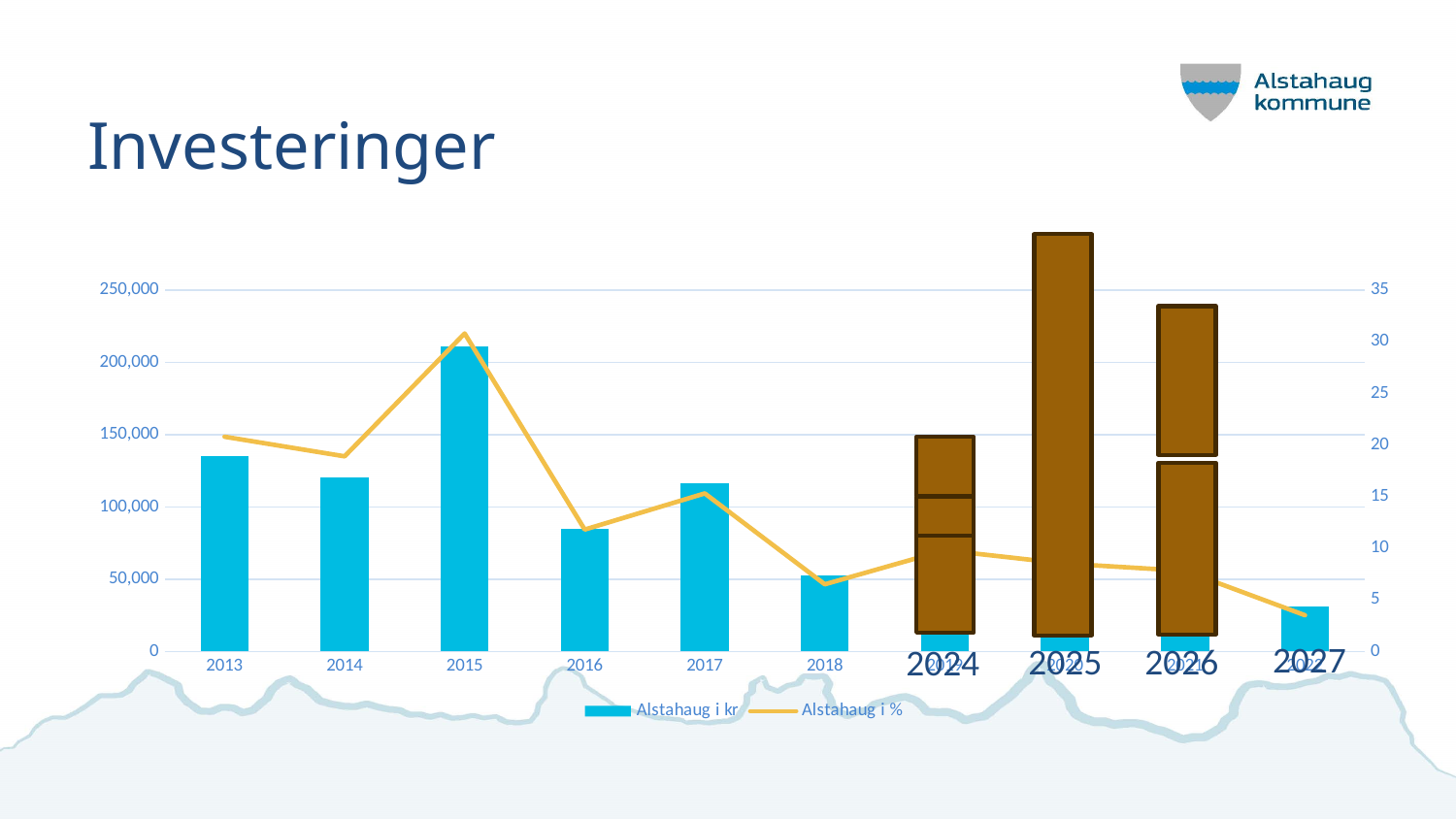
Which year has the highest bar for Alstahaug i kr? 2015 Do the Alstahaug i kr bars rise or fall from 2015 to 2018? fall Is the Alstahaug i kr bar for 2013 greater or less than 150,000? less Is the Alstahaug i kr bar for 2016 greater or less than 100,000? less What are the two series named in the legend? Alstahaug i kr and Alstahaug i % Which year has the larger Alstahaug i kr bar, 2013 or 2014? 2013 In which year does the Alstahaug i % line reach its highest point? 2015 What kind of chart is shown on the slide? A combined bar and line chart Is the Alstahaug i kr bar for 2017 greater or less than 100,000? greater How many series does the legend list? 2